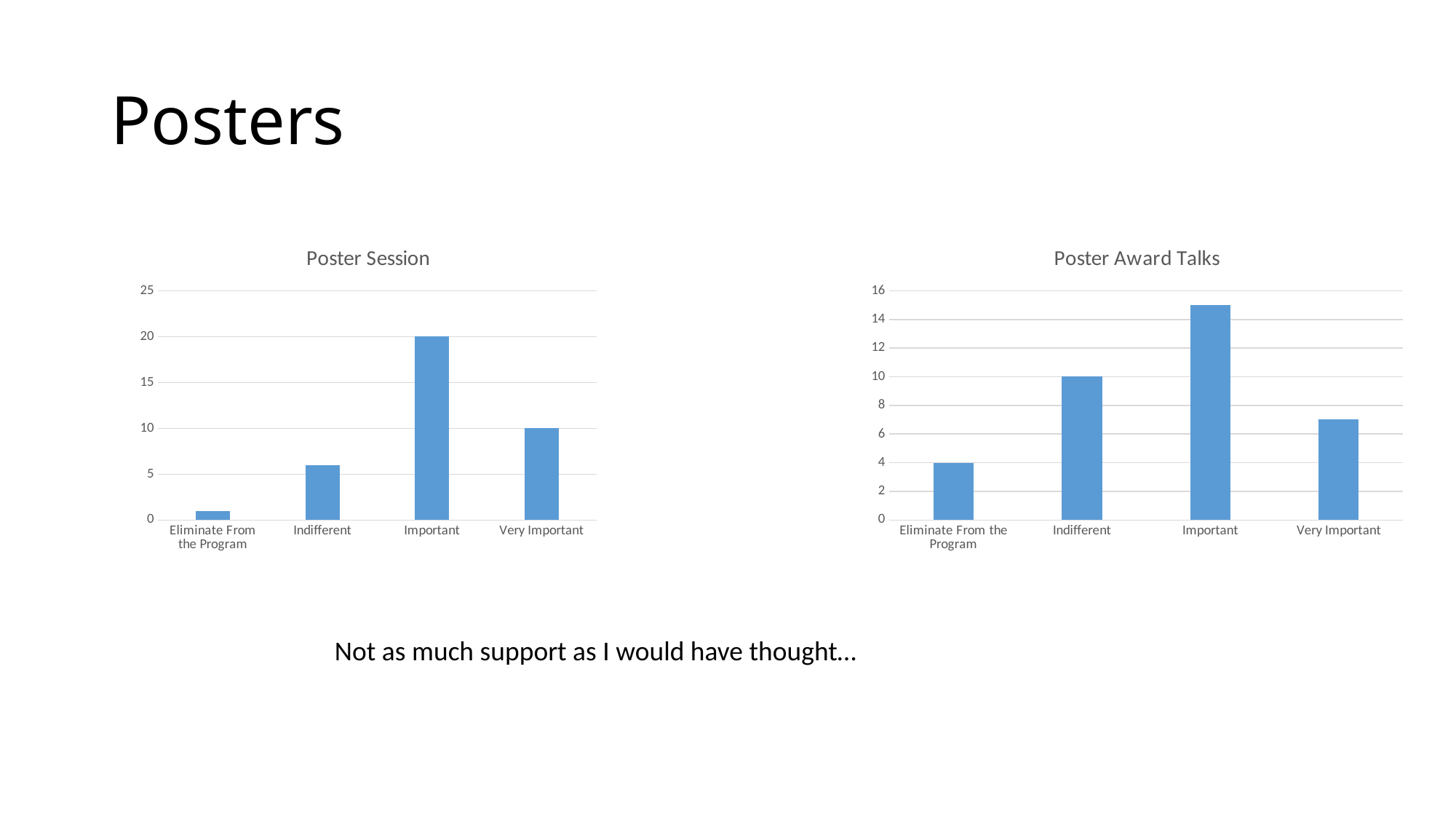
In the Poster Award Talks chart, is the value for Important greater or less than 14? greater In the Poster Session chart, is the value for Indifferent greater or less than 5? greater In the Poster Session chart, what is the difference between the values for Important and Very Important? 10 In the Poster Session chart, which category has the highest value? Important In the Poster Session chart, what is the value for Very Important? 10 In the Poster Award Talks chart, is the value for Indifferent larger or smaller than the value for Very Important? larger In the Poster Award Talks chart, which category has the lowest value? Eliminate From the Program In the Poster Award Talks chart, what is the value for Indifferent? 10 In the Poster Session chart, what is the value for Important? 20 What type of chart is the Poster Session chart? bar chart In the Poster Award Talks chart, what is the value for Eliminate From the Program? 4 How many categories are shown in the Poster Award Talks chart? 4